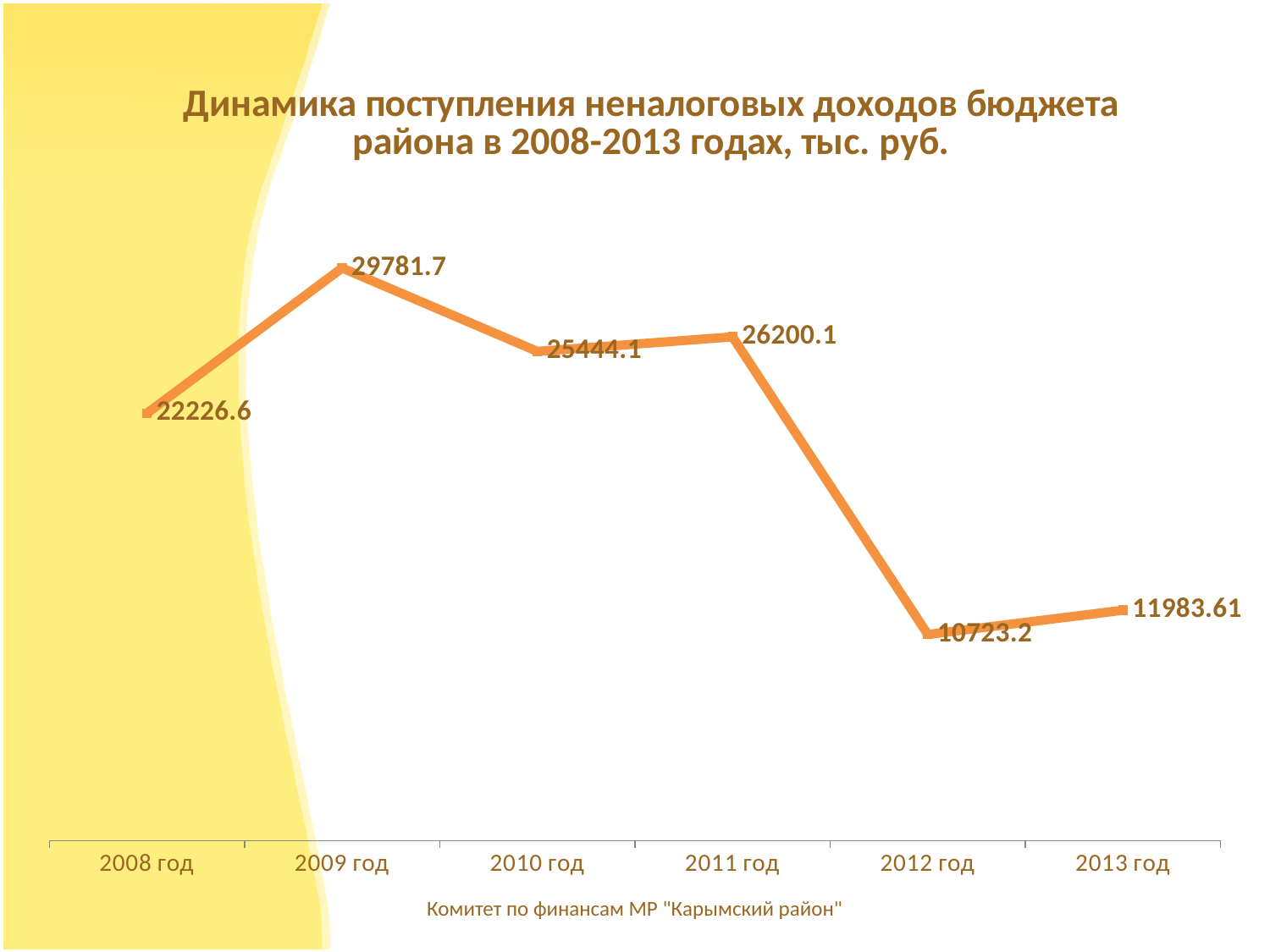
What is the value for 2013 год? 11983.61 What is the value for 2008 год? 22226.6 Which year has the lowest value? 2012 год Does the value rise or fall from 2011 год to 2012 год? fall Which year has the highest value? 2009 год How many years are plotted on the chart? 6 What is the difference between the values for 2011 год and 2010 год? 756 What is the value for 2009 год? 29781.7 Which is larger, the value for 2010 год or the value for 2011 год? 2011 год What is the difference between the values for 2013 год and 2012 год? 1260.41 What kind of chart is shown on the slide? line chart What is the difference between the values for 2009 год and 2008 год? 7555.1